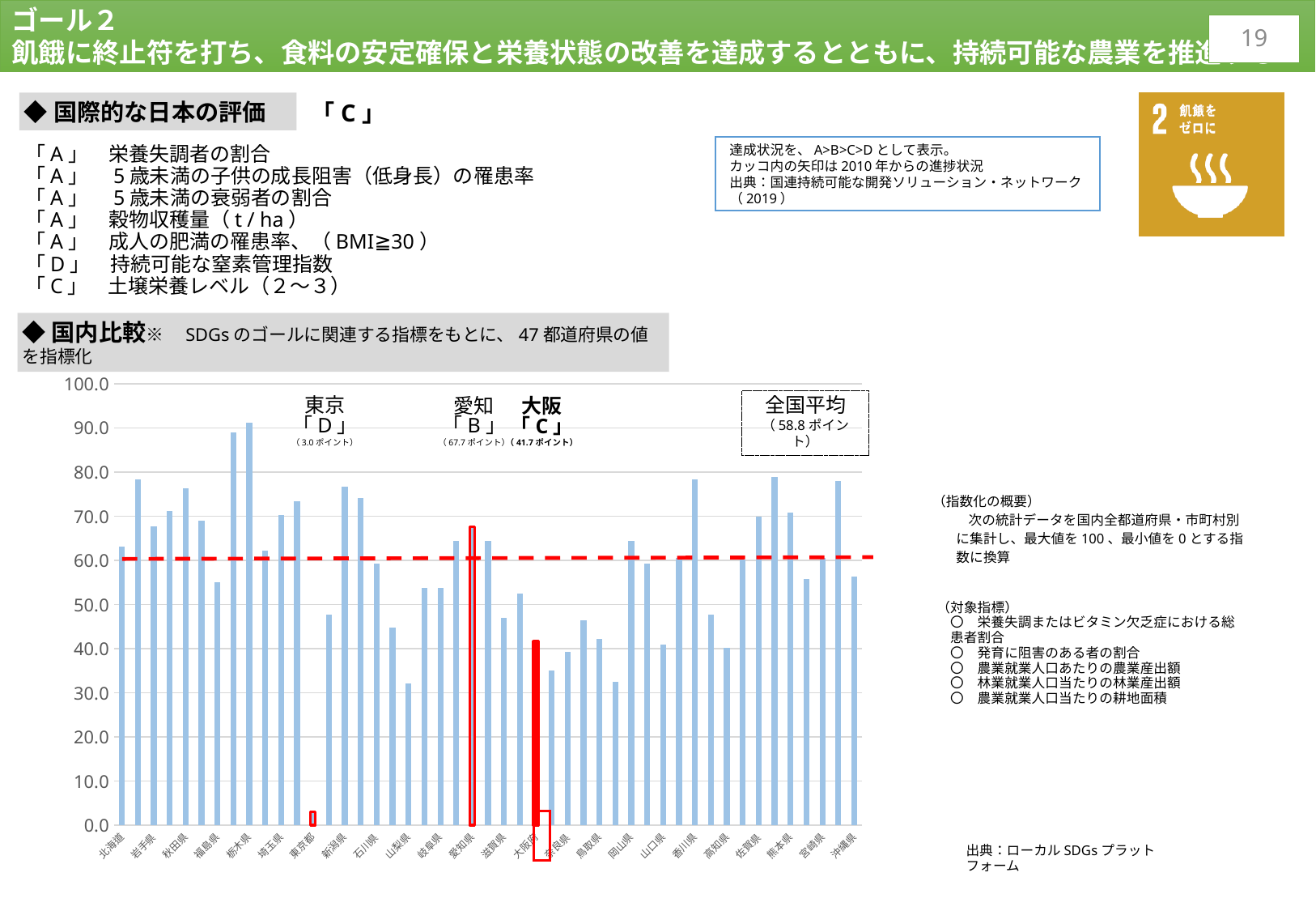
国内比較のグラフで、愛知の値は何ポイントですか？ 67.7ポイント 国内比較のグラフで、愛知と大阪ではどちらの値が大きいですか？ 愛知 国内比較のグラフで、全国平均は何ポイントですか？ 58.8ポイント 国内比較のグラフで、大阪の値は何ポイントですか？ 41.7ポイント 国内比較のグラフで、東京の評価は何ですか？ 「D」 国内比較のグラフで、最も値が低い都道府県はどこですか？ 東京 国内比較のグラフで、山梨県の値は50より大きいですか、小さいですか？ 小さい 国内比較のグラフで、東京の値は何ポイントですか？ 3.0ポイント 国内比較のグラフで、栃木県の値は80より大きいですか、小さいですか？ 大きい 国内比較のグラフで、愛知と大阪の値の差は何ポイントですか？ 26.0ポイント 国内比較のグラフはどの種類のグラフですか？ 棒グラフ 国内比較のグラフで、全国平均と大阪の値の差は何ポイントですか？ 17.1ポイント